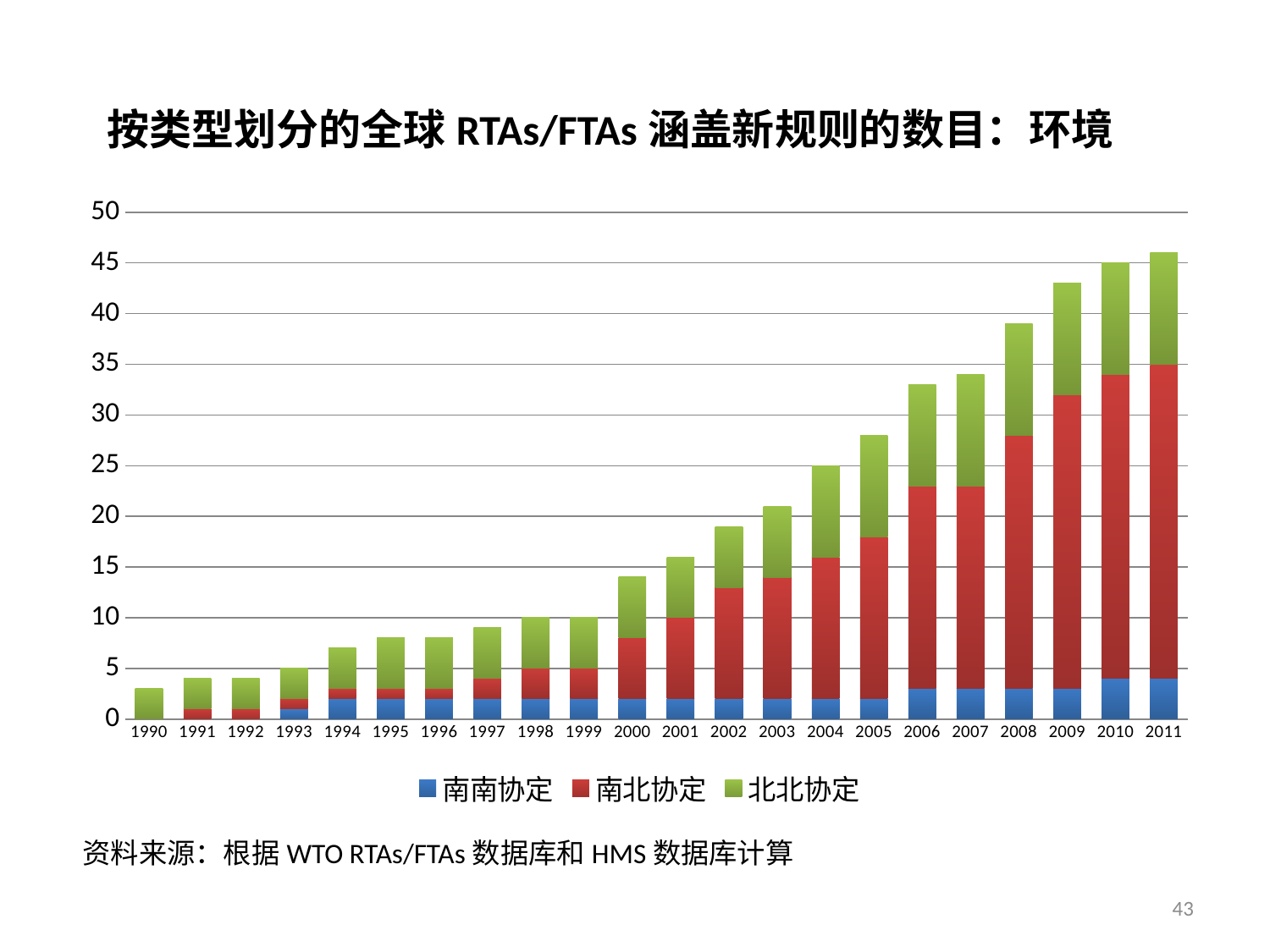
Which year has a larger total bar, 2005 or 2006? 2006 How many series does the legend list? 3 Do the total bar heights generally rise or fall from 1990 to 2011? rise Which year has the highest total bar? 2011 Is the total for 1990 greater or less than 5? less Is the total for 2011 greater or less than 45? greater What kind of chart is shown on the slide? stacked bar chart Is the total for 2000 greater or less than 15? less Which year has the lowest total bar? 1990 How many years are shown on the x axis? 22 Which series is shown in green in the legend? 北北协定